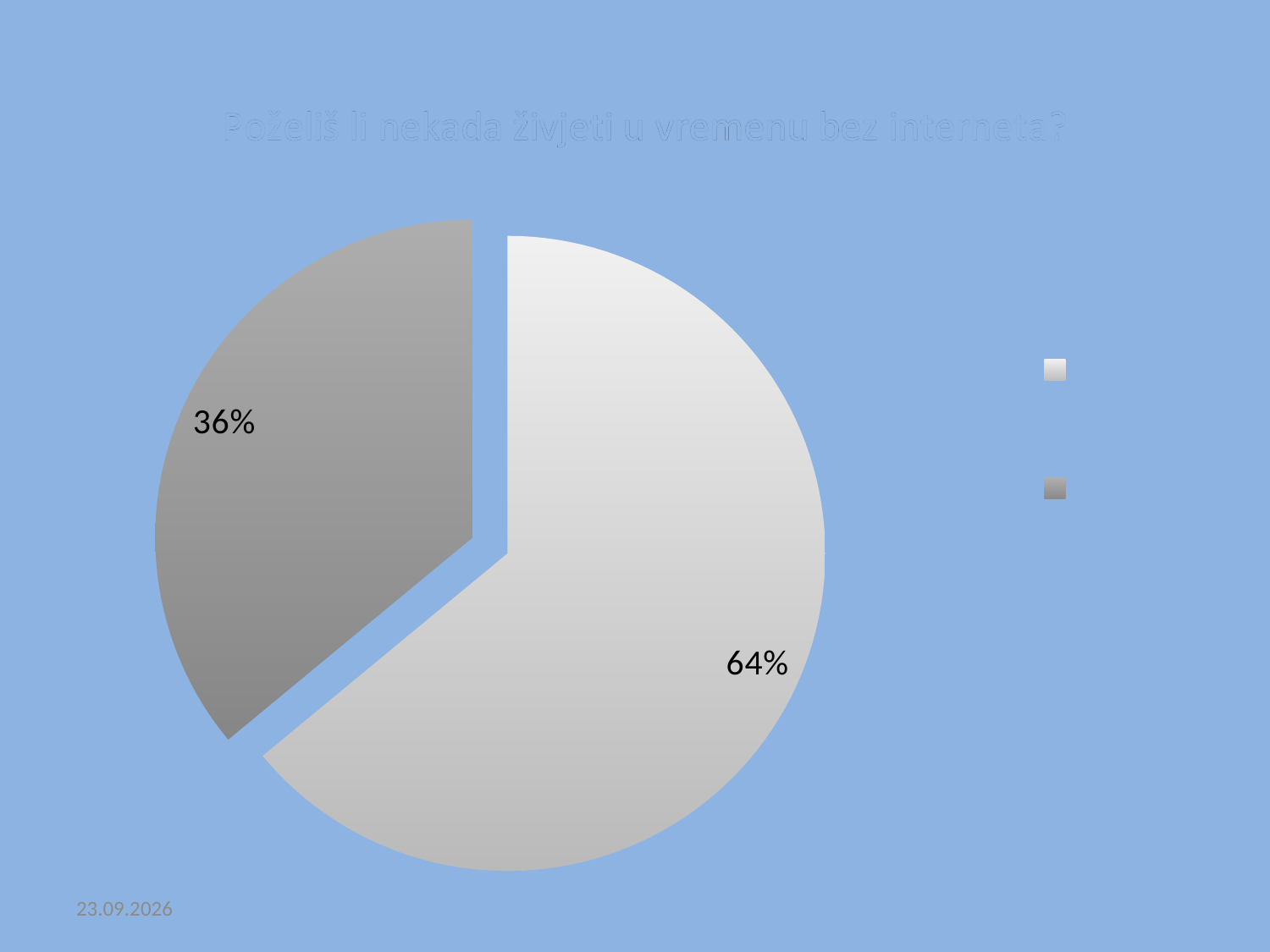
What kind of chart is shown on the slide? pie chart Which slice of the pie chart is the smallest? the dark grey slice (36%) What share of the pie does the dark grey slice represent? 36% How many entries does the legend of the pie chart show? 2 What is the difference in percentage points between the two slices of the pie chart? 28 What percentage is shown on the light grey slice of the pie chart? 64% Which slice of the pie chart is the largest? the light grey slice (64%) Is the value of the light grey slice greater or less than 50%? greater What percentage is shown on the dark grey slice of the pie chart? 36% What is the title of the chart on the slide? Poželiš li nekada živjeti u vremenu bez interneta? How many slices does the pie chart have? 2 Is the light grey slice or the dark grey slice larger in the pie chart? the light grey slice